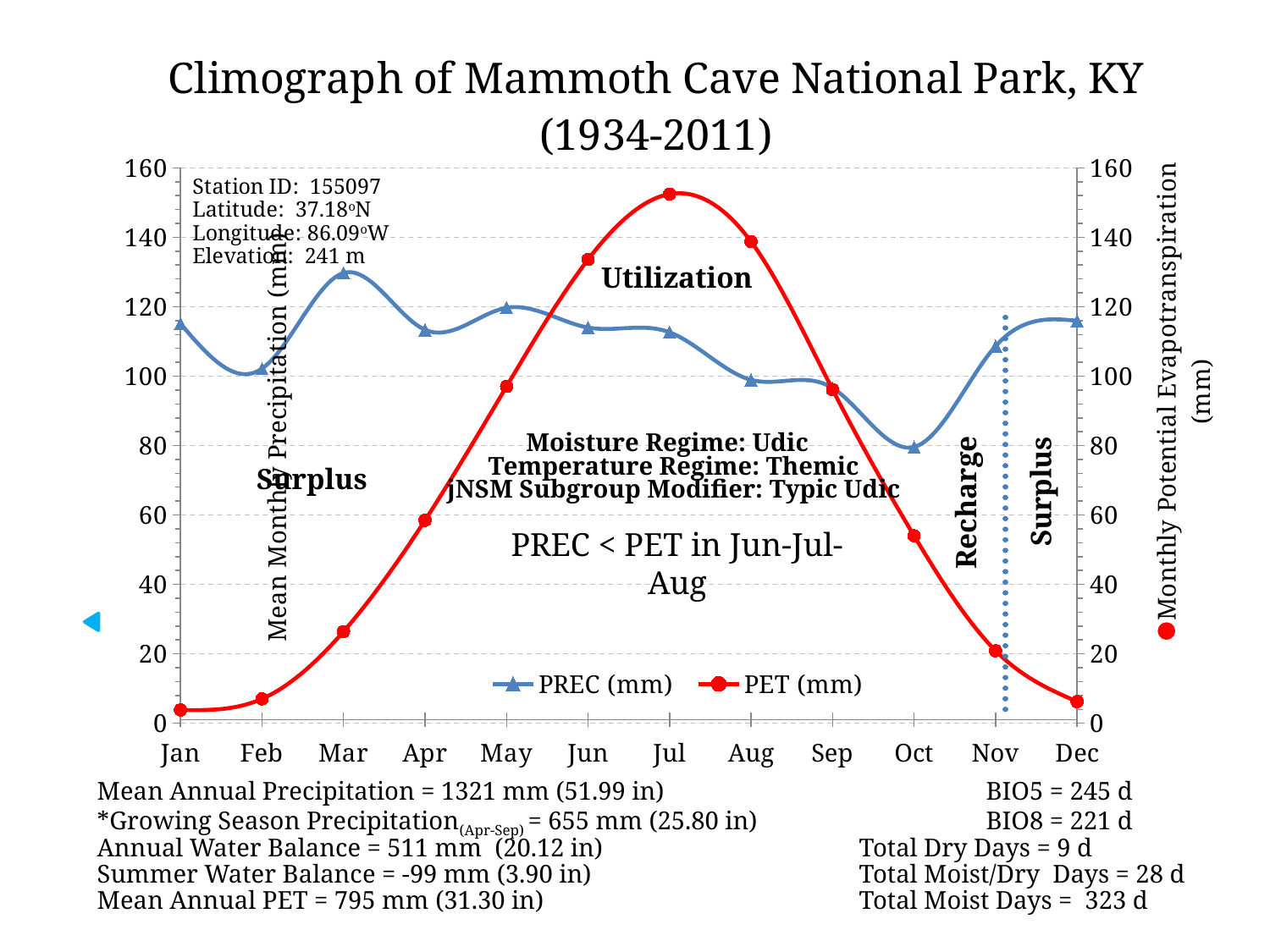
How many series does the legend list? 2 In which month is PREC (mm) at its lowest? Oct Is the value for PREC (mm) in Oct greater or less than 100? less How many months are plotted along the x axis? 12 Is the value for PET (mm) in Mar greater or less than 40? less Which is larger in Aug, PREC (mm) or PET (mm)? PET (mm) In which month is PREC (mm) at its highest? Mar Does PET (mm) rise or fall from Jan to Jul? rise What kind of chart is shown on the slide? line chart What are the two series named in the legend? PREC (mm) and PET (mm) In which month does PET (mm) reach its highest value? Jul Is the value for PET (mm) in Jul greater or less than 140? greater